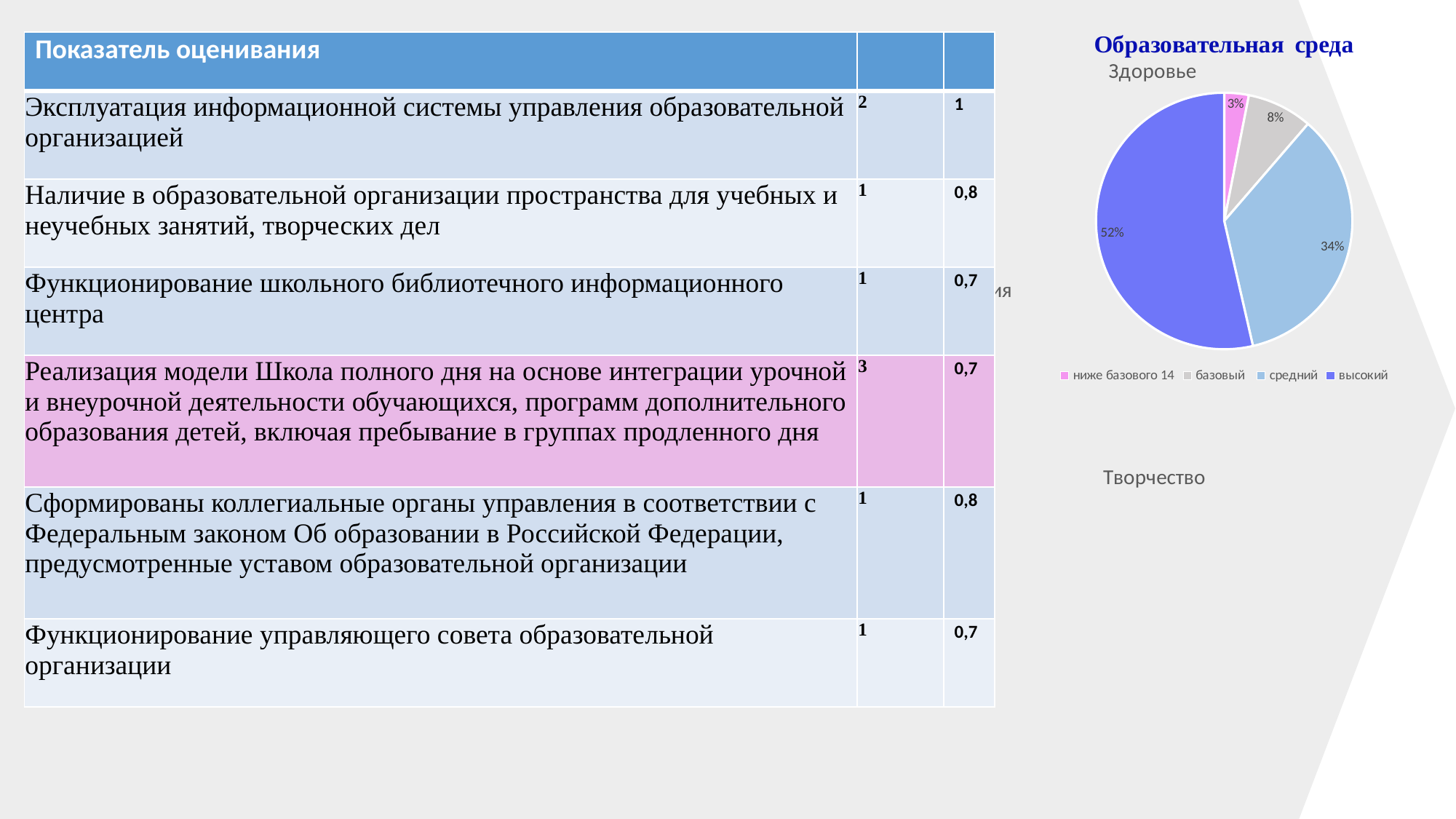
What share of the pie chart does the 'базовый' slice take? 8% What is the title of the pie chart? Образовательная среда What share of the pie chart does the 'средний' slice take? 34% Which category has the largest slice in the pie chart? высокий What share of the pie chart does the 'высокий' slice take? 52% Which slice is larger in the pie chart, 'базовый' or 'ниже базового 14'? базовый How many entries does the legend of the pie chart list? 4 What is the difference in percentage points between the 'высокий' and 'средний' slices? 18% Which category has the smallest slice in the pie chart? ниже базового 14 What kind of chart is shown on the right side of the slide? pie chart How many slices does the pie chart have? 4